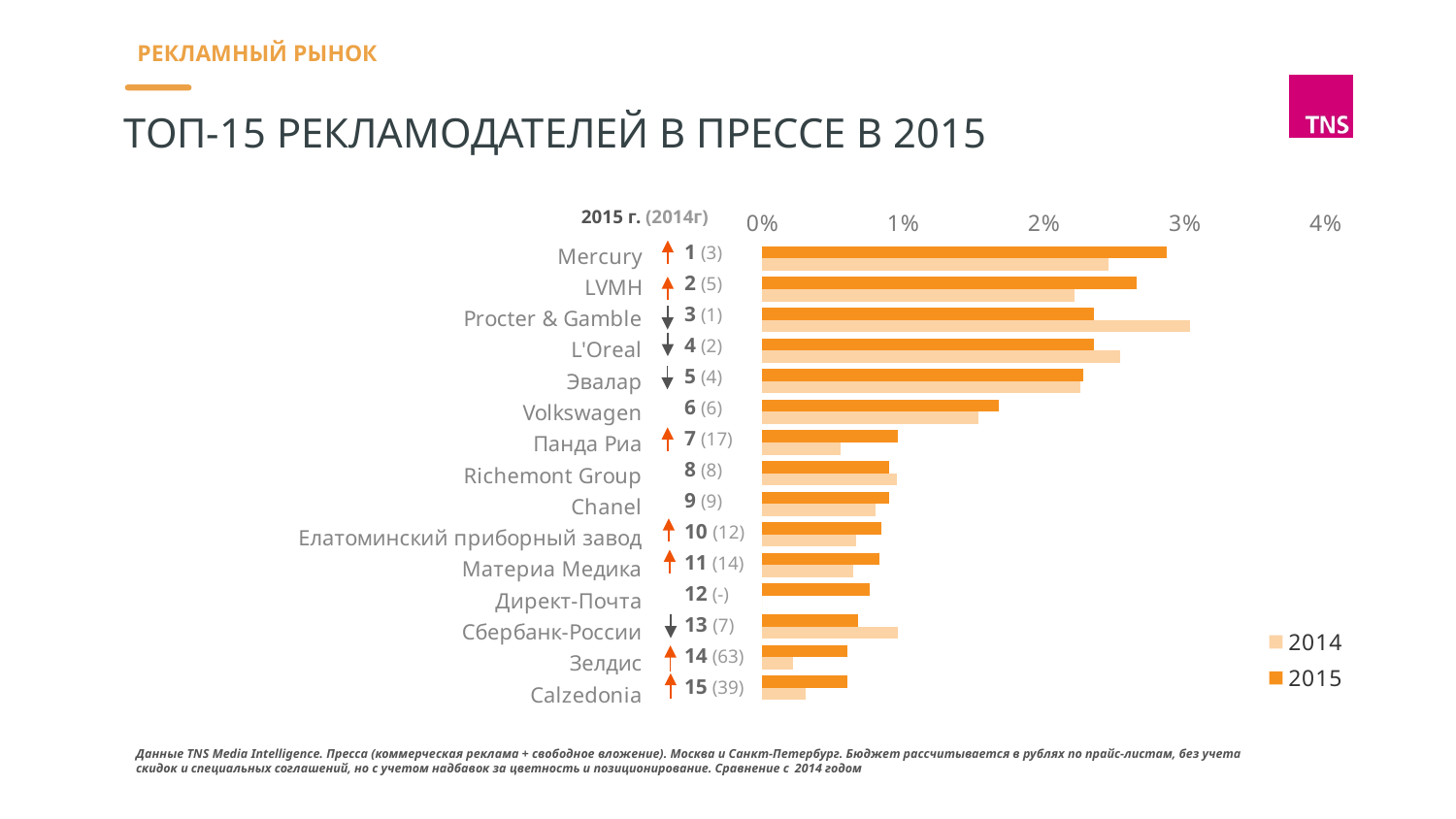
Is the 2015 value for Volkswagen greater or less than 2%? less Which advertiser has the highest 2014 value? Procter & Gamble How many advertisers are shown in the chart? 15 For Procter & Gamble, which is larger: the 2014 value or the 2015 value? 2014 Is the 2015 value for Mercury greater or less than 2%? greater What rank did Calzedonia hold in 2014, according to the chart? 39 Which advertiser has the highest 2015 value? Mercury What kind of chart is shown on the slide? bar chart For Зелдис, which is larger: the 2014 value or the 2015 value? 2015 How many series does the legend list? 2 Which series is shown in the darker orange colour? 2015 Is the 2014 value for Панда Риа greater or less than 1%? less